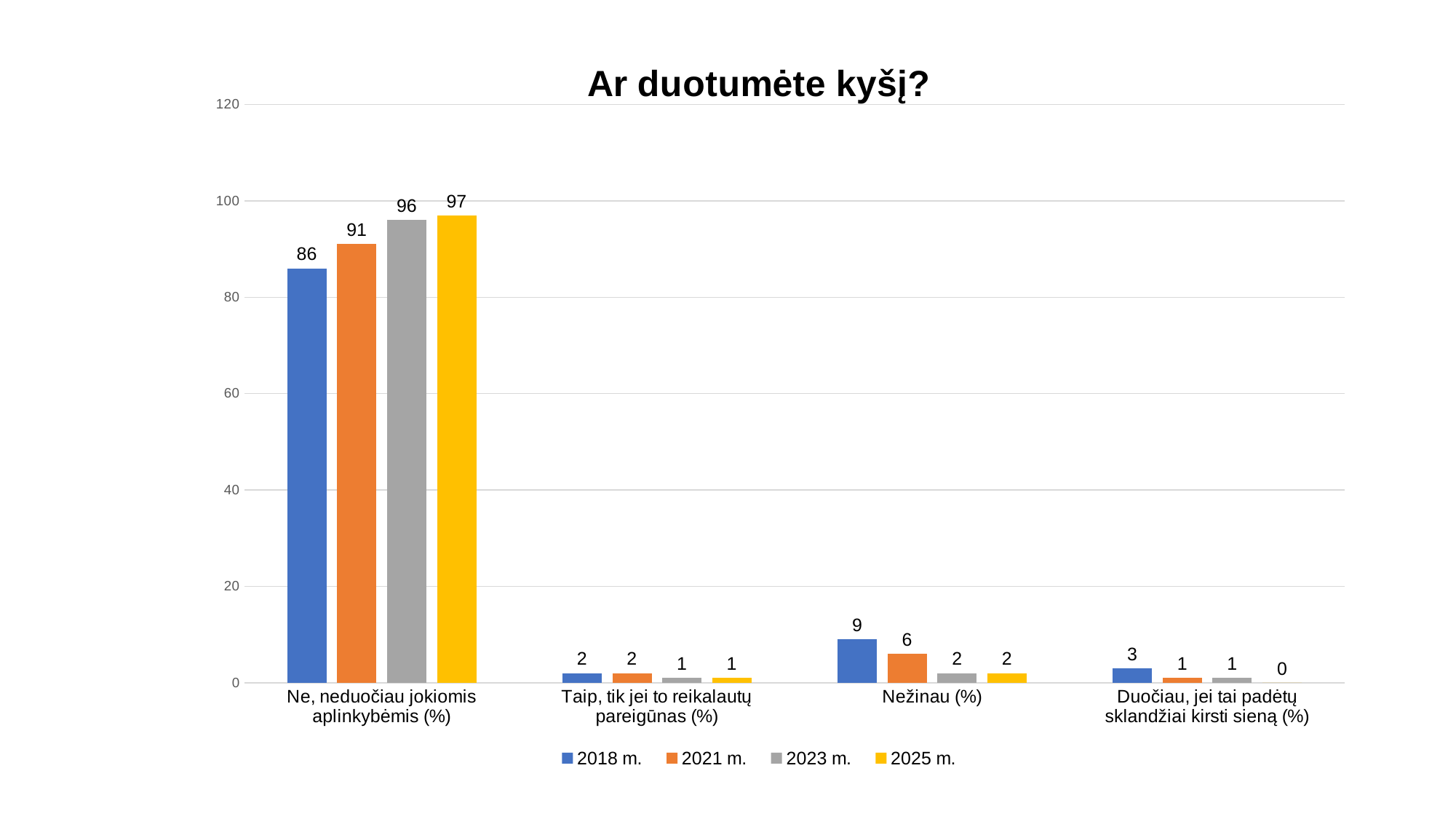
What is the value for 2025 m. in the category "Nežinau (%)"? 2 What is the value for 2018 m. in the category "Ne, neduočiau jokiomis aplinkybėmis (%)"? 86 Which year has the lowest value in the category "Nežinau (%)"? 2023 m. and 2025 m. (tie at 2) How many series does the legend list? 4 How many categories are shown on the x axis? 4 Which is larger in the category "Nežinau (%)": the value for 2018 m. or the value for 2021 m.? 2018 m. What is the difference between the 2025 m. and 2018 m. values in the category "Ne, neduočiau jokiomis aplinkybėmis (%)"? 11 What is the title of the chart? Ar duotumėte kyšį? Which year has the highest value in the category "Ne, neduočiau jokiomis aplinkybėmis (%)"? 2025 m. What is the value for 2021 m. in the category "Duočiau, jei tai padėtų sklandžiai kirsti sieną (%)"? 1 What kind of chart is shown on the slide? bar chart Is the value for 2021 m. in the category "Ne, neduočiau jokiomis aplinkybėmis (%)" greater or less than 80? greater